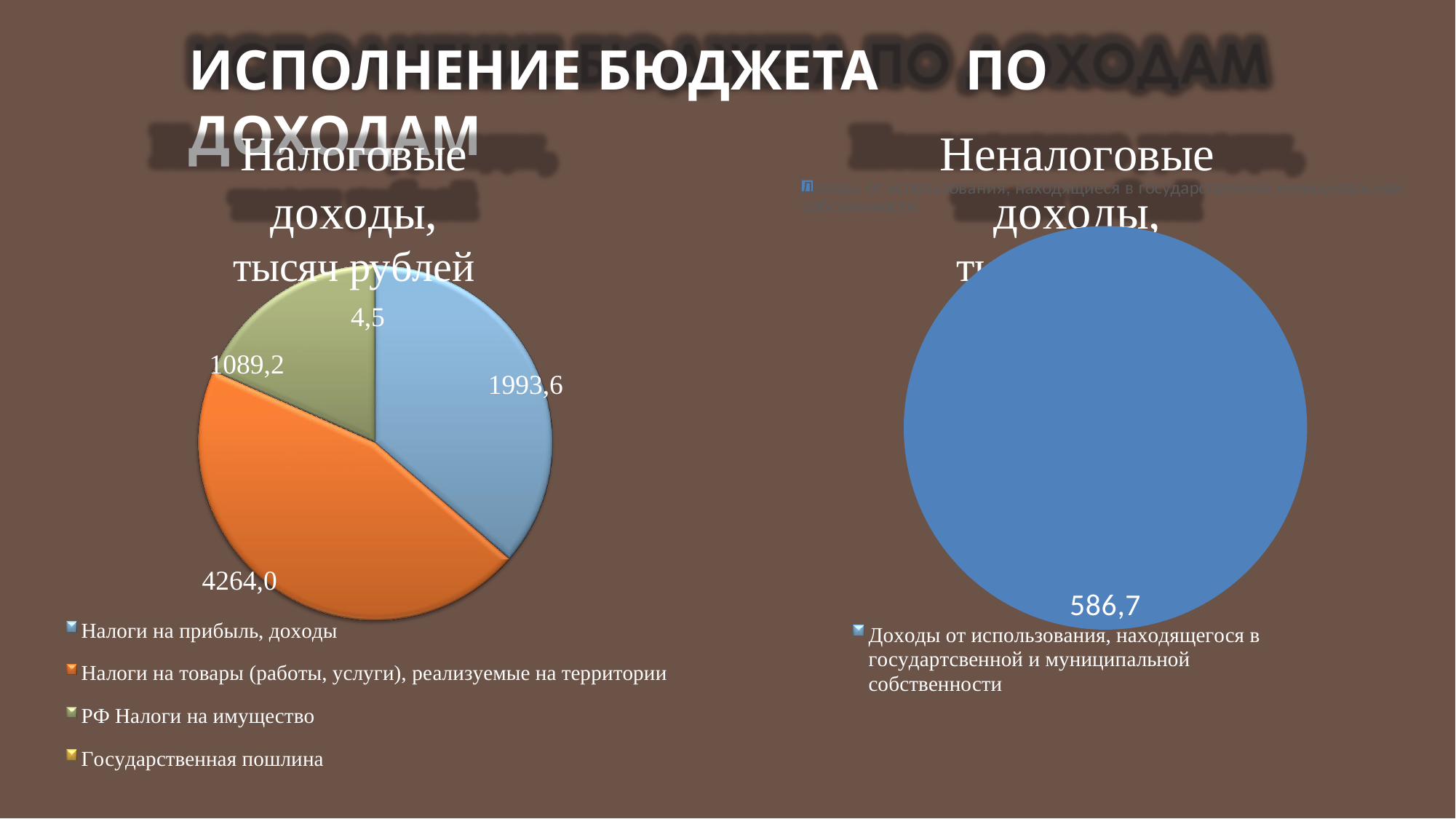
In the chart titled "Налоговые доходы, тысяч рублей", what is the value for "Государственная пошлина"? 4,5 In the chart on the right (Неналоговые доходы), what is the value shown for "Доходы от использования, находящегося в государственной и муниципальной собственности"? 586,7 In the chart titled "Налоговые доходы, тысяч рублей", which category has the smallest value? Государственная пошлина In the chart titled "Налоговые доходы, тысяч рублей", which category has the largest value? Налоги на товары (работы, услуги), реализуемые на территории In the chart titled "Налоговые доходы, тысяч рублей", which is larger: "Налоги на прибыль, доходы" or "РФ Налоги на имущество"? Налоги на прибыль, доходы In the chart titled "Налоговые доходы, тысяч рублей", what is the value for "Налоги на товары (работы, услуги), реализуемые на территории"? 4264,0 How many categories does the legend of the chart titled "Налоговые доходы, тысяч рублей" list? 4 What type of chart is the chart titled "Налоговые доходы, тысяч рублей"? Pie chart In the chart titled "Налоговые доходы, тысяч рублей", what is the difference between the values for "Налоги на товары (работы, услуги), реализуемые на территории" and "Налоги на прибыль, доходы"? 2270,4 In the chart titled "Налоговые доходы, тысяч рублей", what is the value for "Налоги на прибыль, доходы"? 1993,6 In the chart titled "Налоговые доходы, тысяч рублей", what colour is the slice for "Налоги на товары (работы, услуги), реализуемые на территории"? Orange In the chart titled "Налоговые доходы, тысяч рублей", what is the value for "РФ Налоги на имущество"? 1089,2